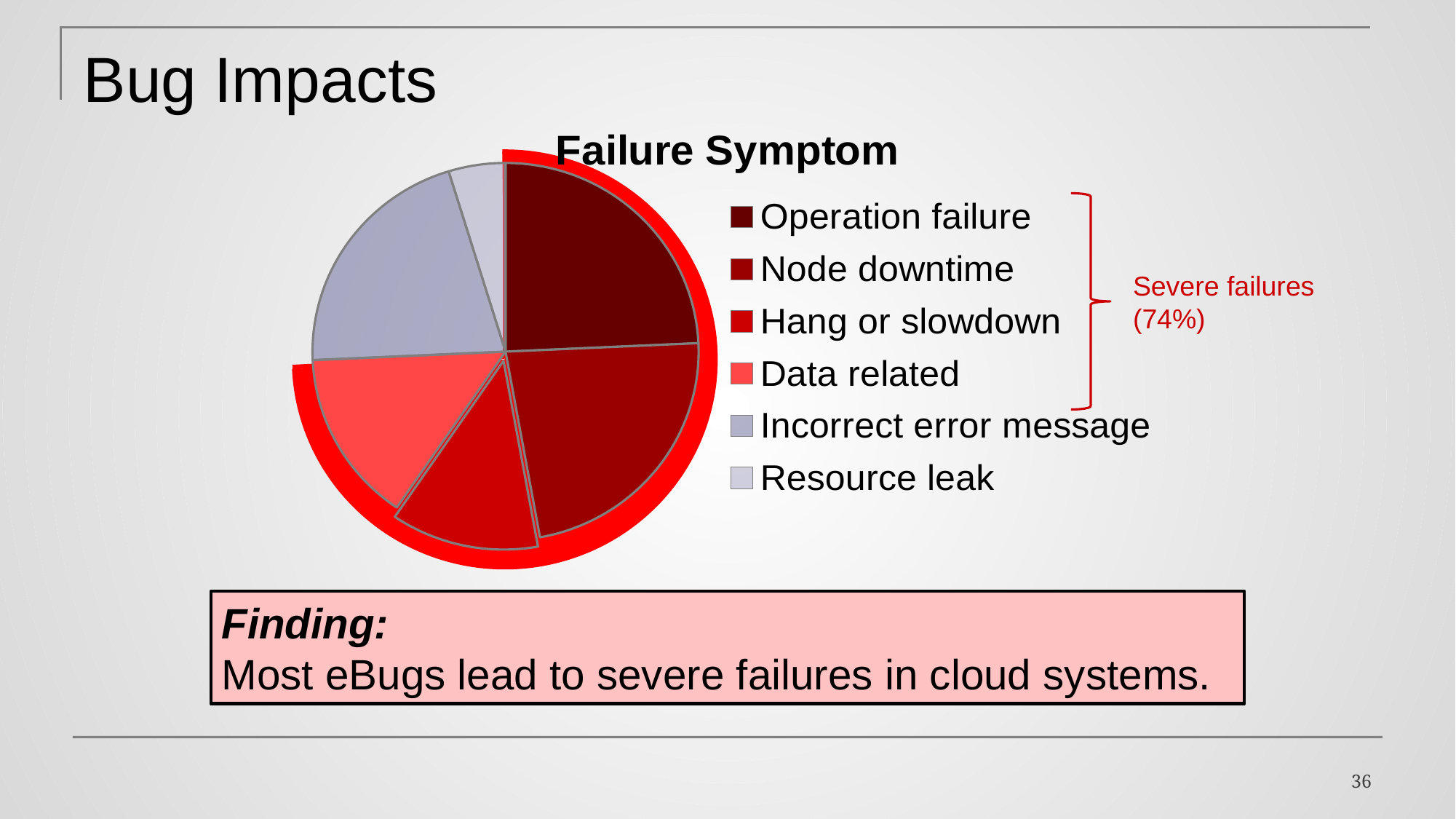
Which legend entries are grouped under the 'Severe failures' bracket? Operation failure, Node downtime, Hang or slowdown, Data related What is the title of the chart? Failure Symptom Which slice is larger, Incorrect error message or Resource leak? Incorrect error message According to the annotation, what share of failures are severe failures? 74% How many entries does the legend list? 6 What kind of chart is shown on the slide? pie chart Which slice is larger, Operation failure or Resource leak? Operation failure Which slice is larger, Node downtime or Data related? Node downtime Which category has the smallest slice of the pie? Resource leak How many categories does the pie chart have? 6